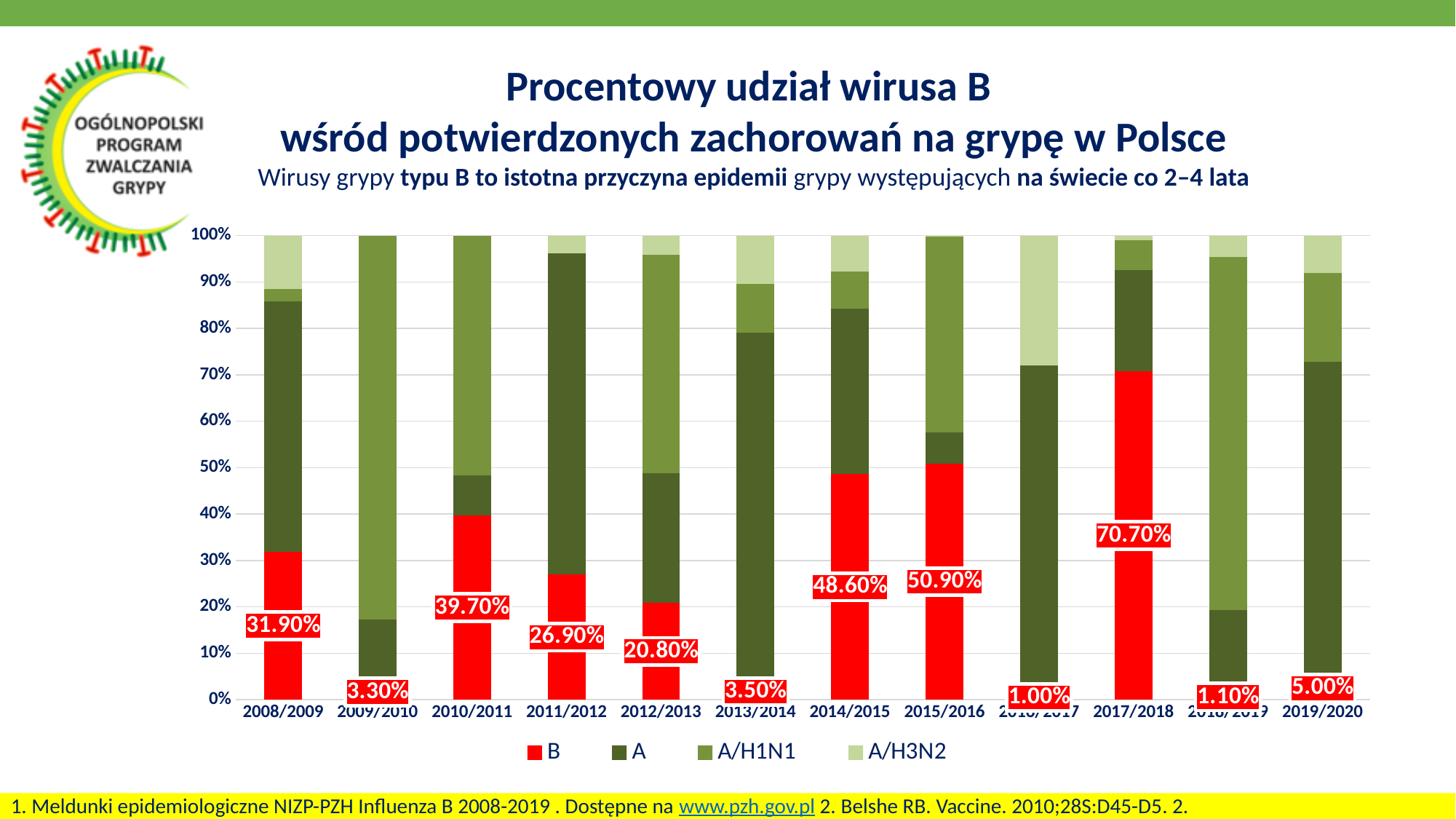
In which season was the share of virus B the highest? 2017/2018 What is the difference between the B share in 2015/2016 and in 2014/2015? 2.30% What is the percentage share of virus B in the 2017/2018 season? 70.70% What is the difference between the B share in 2017/2018 and in 2008/2009? 38.80% How many series does the chart legend list? 4 What is the percentage share of virus B in the 2014/2015 season? 48.60% Which season had a larger share of virus B, 2010/2011 or 2011/2012? 2010/2011 In which season was the share of virus B the lowest? 2016/2017 What type of chart is shown on the slide? Stacked bar chart How many seasons are shown on the x axis of the chart? 12 What is the percentage share of virus B in the 2012/2013 season? 20.80% Is the share of the A segment in the 2019/2020 season greater or less than 60%? greater